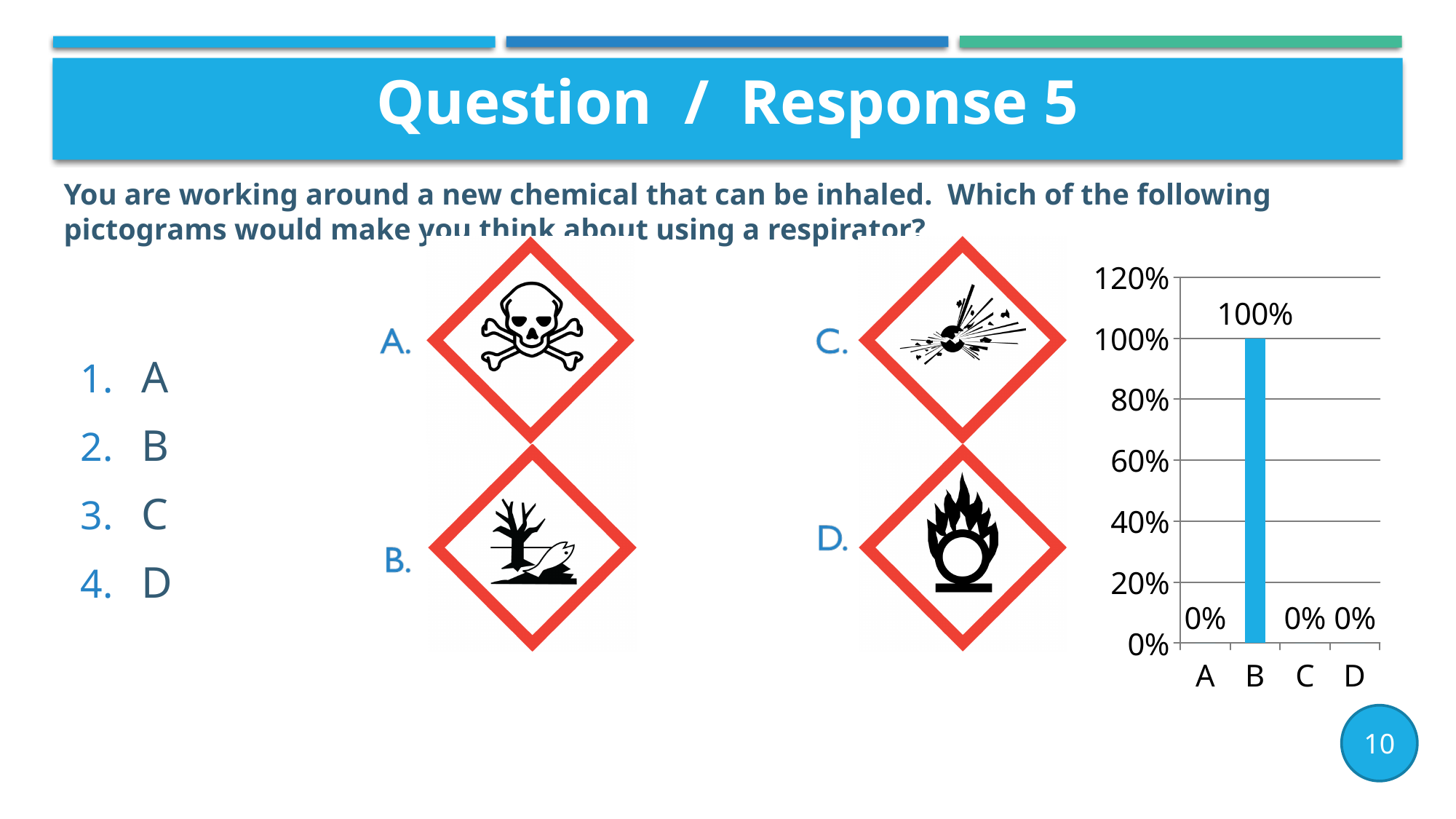
Which is larger in the chart, the value for B or the value for A? B Is the value for B in the chart greater or less than 80%? greater What is the value for B in the chart? 100% What is the value for A in the chart? 0% How many categories are shown on the x axis of the chart? 4 Which category has the highest value in the chart? B What kind of chart is shown on the slide? bar chart What is the value for D in the chart? 0% What colour is the bar for B in the chart? blue What is the difference between the values for B and C in the chart? 100% What is the highest tick value shown on the y axis of the chart? 120%